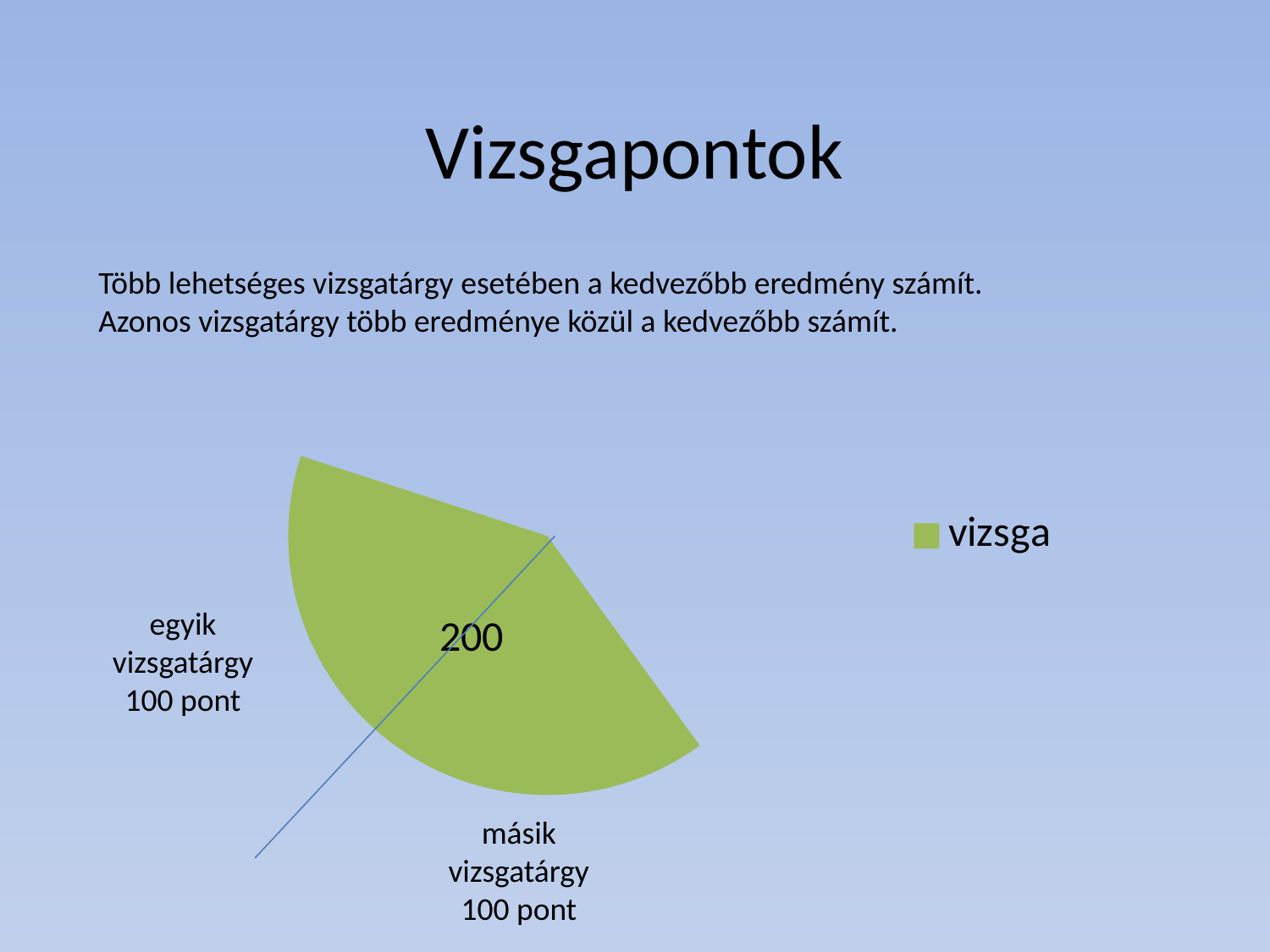
What value is printed on the green slice of the pie chart? 200 How many data labels are printed on the pie chart? 1 What is the name of the series shown in the legend of the pie chart? vizsga How many entries does the legend of the pie chart list? 1 What colour is the slice labelled 200 in the pie chart? green What kind of chart is shown on the slide? pie chart